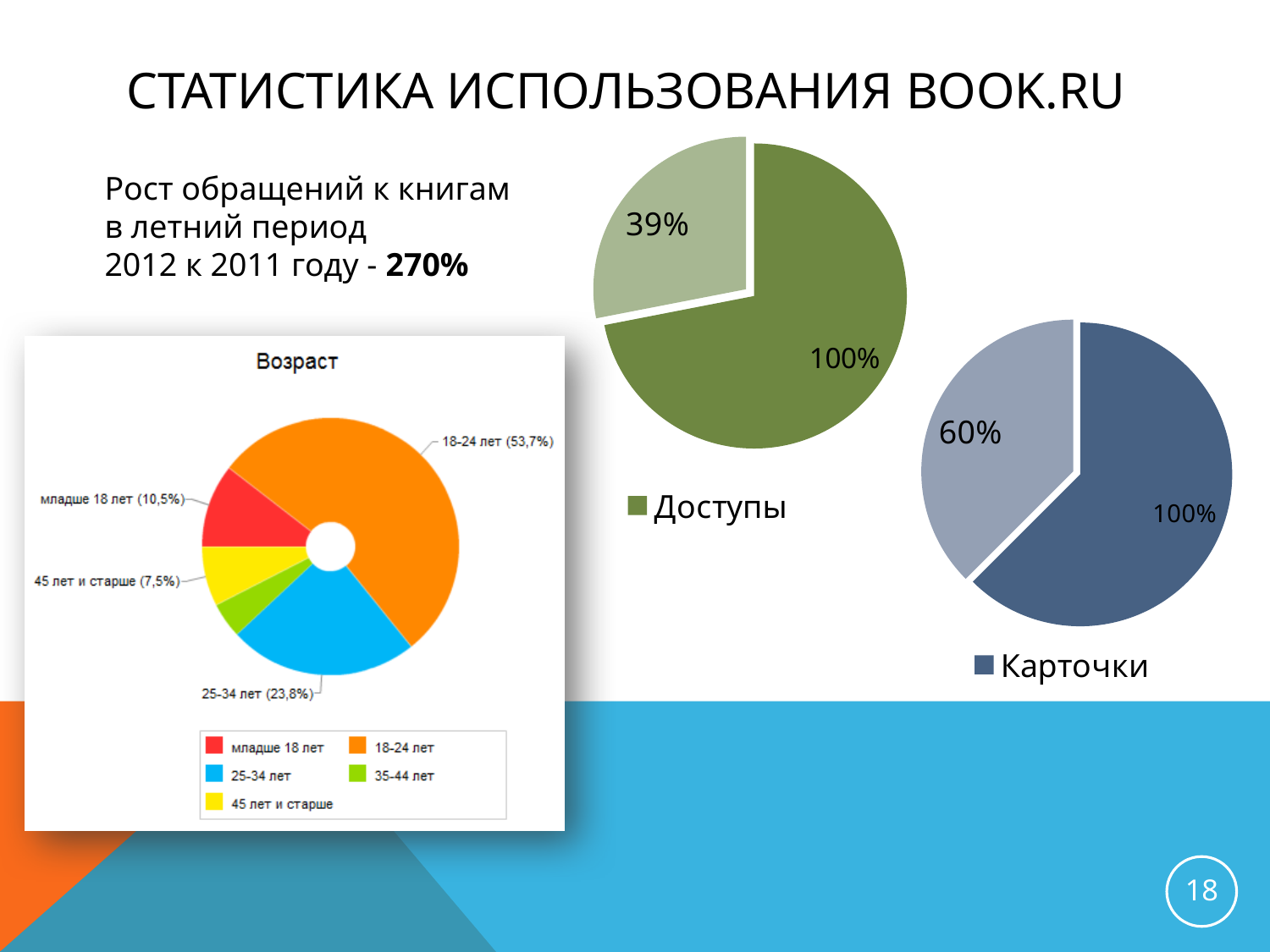
In the "Возраст" chart, which is larger: the share for 25-34 лет or the share for младше 18 лет? 25-34 лет In the "Возраст" chart, what share is shown for младше 18 лет? 10,5% In the "Возраст" chart, what colour represents 18-24 лет? Orange In the "Возраст" chart, what share is shown for 45 лет и старше? 7,5% In the "Возраст" chart, what share is shown for 25-34 лет? 23,8% In the "Возраст" chart, how many age groups does the legend list? 5 In the "Возраст" chart, which age group has the largest share? 18-24 лет In the "Карточки" pie chart, what value is shown on the smaller slice? 60% In the "Возраст" chart, what share is shown for 18-24 лет? 53,7% What kind of chart is the "Возраст" chart? Pie (donut) chart In the "Доступы" pie chart, what value is shown on the smaller slice? 39% In the "Возраст" chart, what is the difference between the shares for 18-24 лет and 25-34 лет? 29,9%